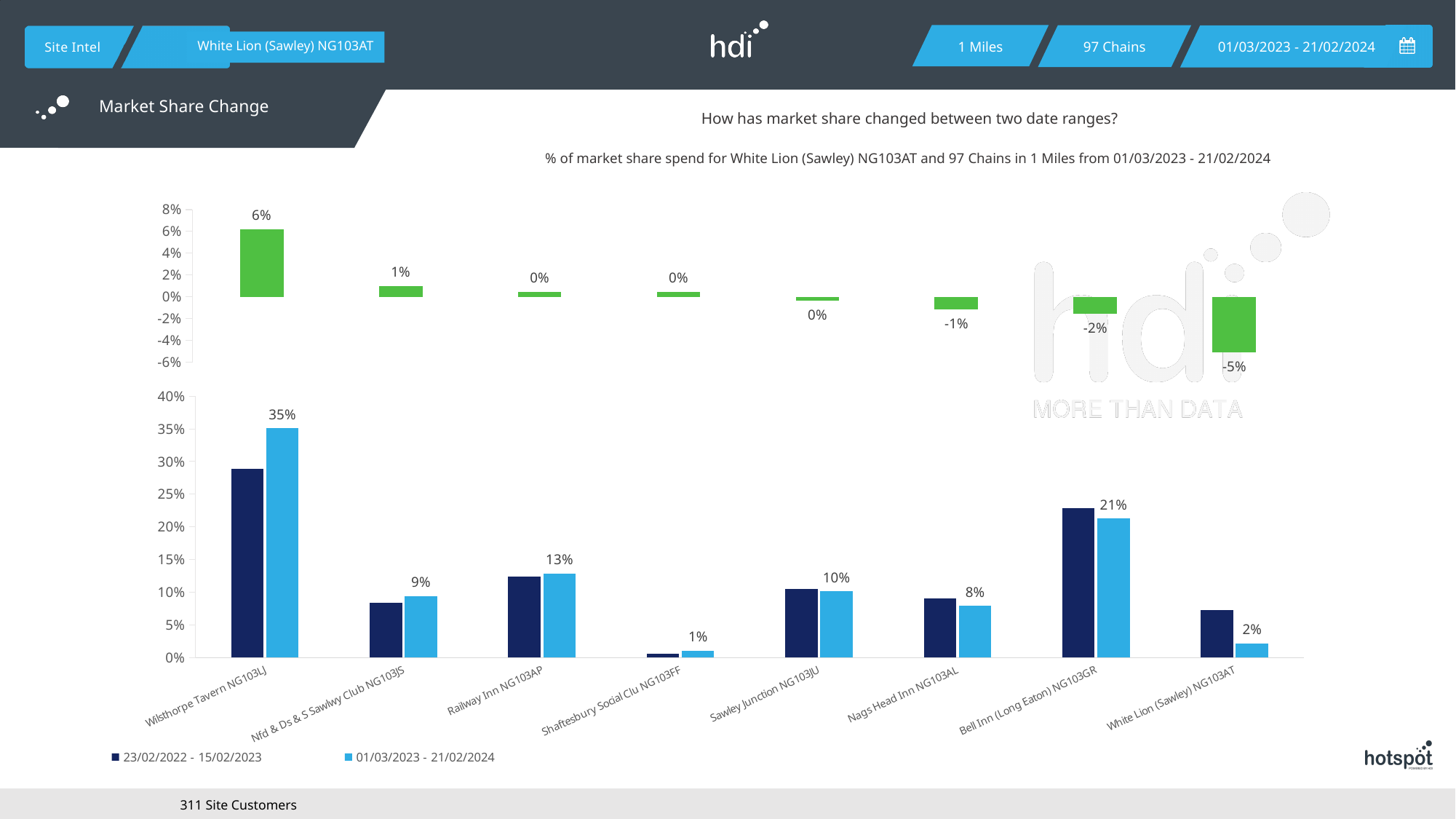
In the top chart (market share change), which category has the lowest value? White Lion (Sawley) NG103AT In the bottom chart, which is larger for Railway Inn NG103AP: the 23/02/2022 - 15/02/2023 value or the 01/03/2023 - 21/02/2024 value? 01/03/2023 - 21/02/2024 How many series does the legend of the bottom chart list? 2 In the top chart (market share change), what is the value for White Lion (Sawley) NG103AT? -5% In the bottom chart, what is the difference between the 01/03/2023 - 21/02/2024 values for Wilsthorpe Tavern NG103LJ and Bell Inn (Long Eaton) NG103GR? 14% In the bottom chart, what is the value for Wilsthorpe Tavern NG103LJ in the 01/03/2023 - 21/02/2024 series? 35% In the bottom chart, what is the value for Bell Inn (Long Eaton) NG103GR in the 01/03/2023 - 21/02/2024 series? 21% How many categories are shown on the x axis of the bottom chart? 8 In the top chart (market share change), which category has the highest value? Wilsthorpe Tavern NG103LJ In the top chart (market share change), what is the value for Bell Inn (Long Eaton) NG103GR? -2% In the bottom chart, is the 23/02/2022 - 15/02/2023 value for Wilsthorpe Tavern NG103LJ greater or less than 25%? greater In the top chart (market share change), what is the value for Wilsthorpe Tavern NG103LJ? 6%